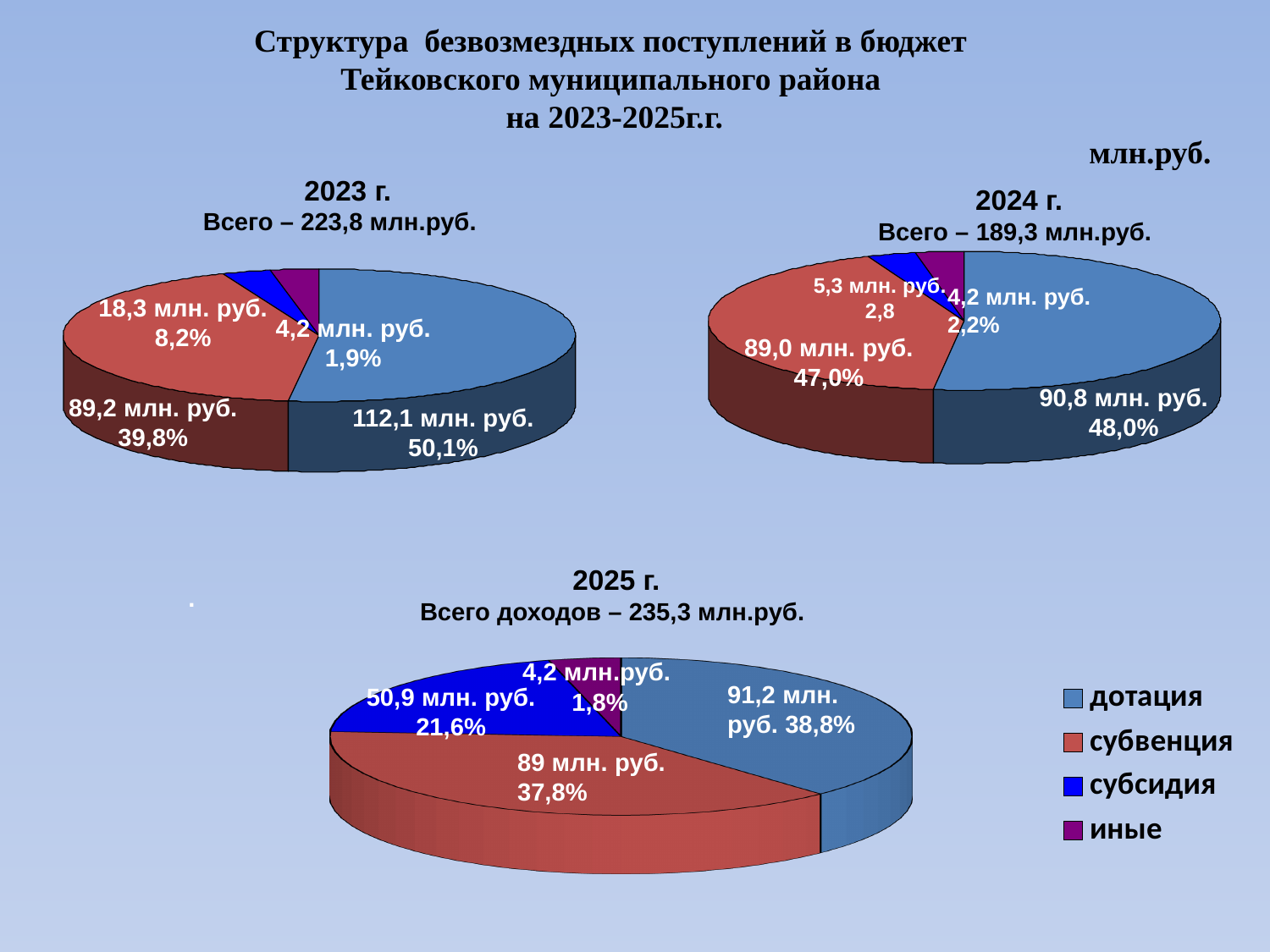
In the 2025 г. chart, what is the difference between the values for дотация and субвенция? 2,2 млн. руб. In the 2024 г. chart, which category has the largest share? дотация In the 2025 г. chart, which category has the smallest share? иные What is the total shown for the 2024 г. chart? 189,3 млн.руб. How many categories does the legend list? 4 What kind of charts are shown on the slide? Pie charts In the 2023 г. chart, what is the value for дотация? 112,1 млн. руб. In the 2025 г. chart, what is the value for субсидия? 50,9 млн. руб. In the 2024 г. chart, which is larger: дотация or субвенция? дотация In the 2023 г. chart, what share of the pie does субвенция take? 39,8% Which colour represents субвенция in the legend? Red In the 2024 г. chart, what is the value for субсидия? 5,3 млн. руб.